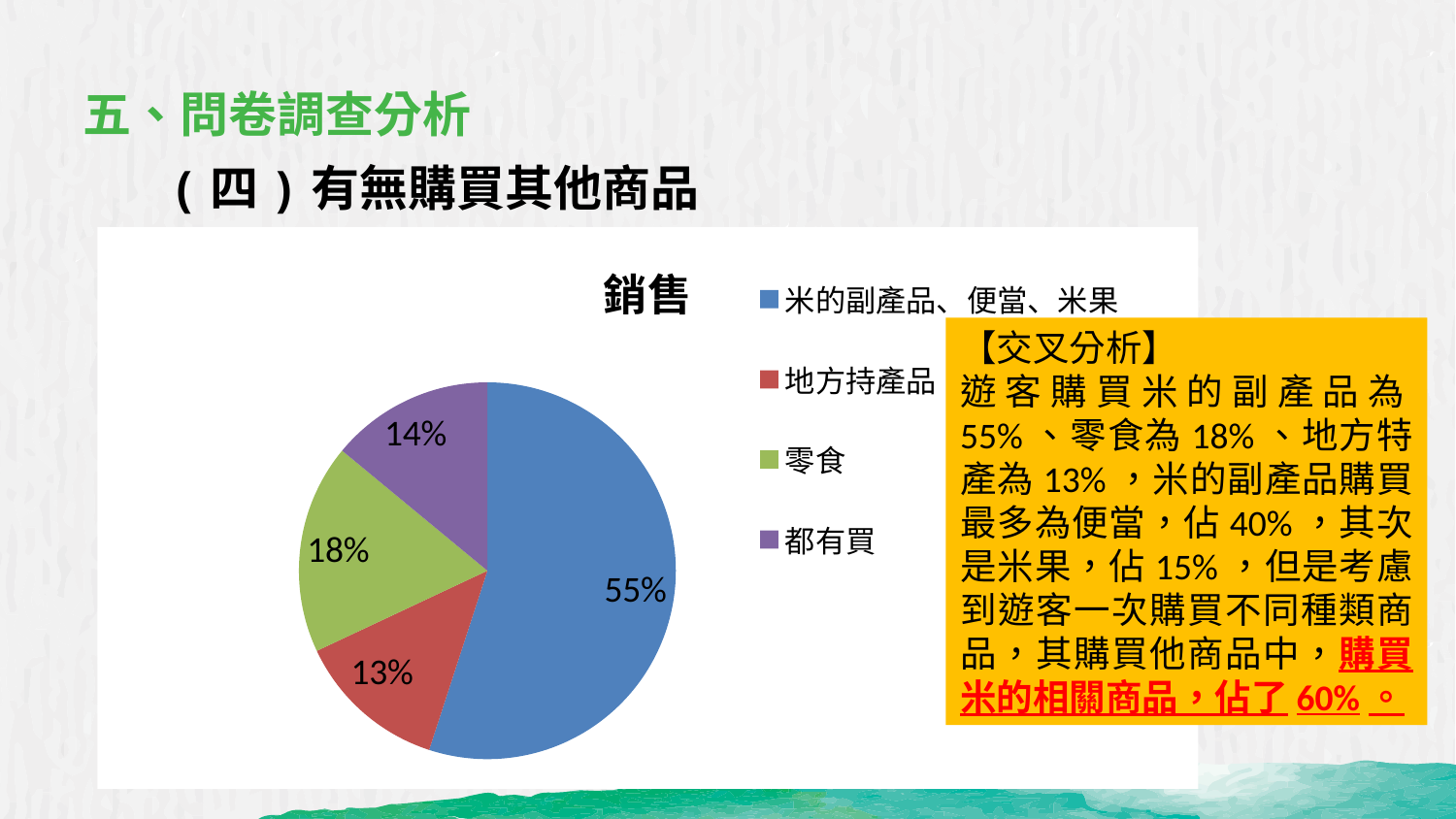
Which colour represents 都有買 in the pie chart? purple What kind of chart is shown on the slide? pie chart What share of the pie is 零食? 18% What share of the pie is 米的副產品、便當、米果? 55% Which category has the smallest slice of the pie? 地方持產品 How many entries does the legend list? 4 What share of the pie is 都有買? 14% Which category has the largest slice of the pie? 米的副產品、便當、米果 What is the title of the chart? 銷售 What is the difference between the shares of 零食 and 地方持產品? 5% How many slices does the pie chart have? 4